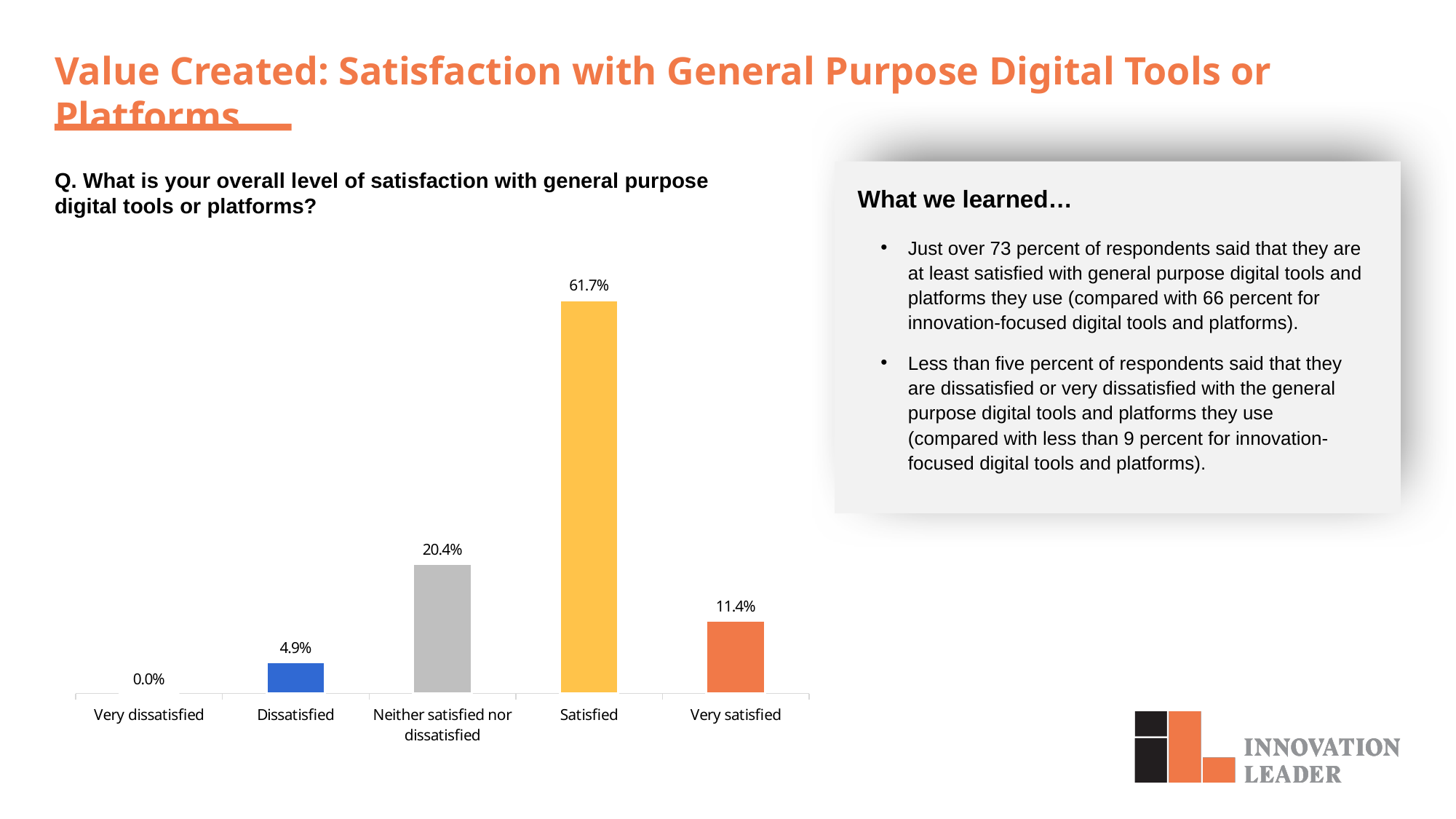
Which category has the highest value? Satisfied How many categories are shown on the x axis of the chart? 5 What is the difference between the Satisfied and Very satisfied values? 50.3% What is the value shown for Neither satisfied nor dissatisfied? 20.4% What colour is the bar for Satisfied? Yellow What kind of chart is shown on the slide? Bar chart What percentage of respondents said they are Satisfied with general purpose digital tools or platforms? 61.7% What is the value shown for Very dissatisfied? 0.0% Which is larger, the value for Neither satisfied nor dissatisfied or the value for Very satisfied? Neither satisfied nor dissatisfied What is the value shown for Very satisfied? 11.4% What is the value shown for Dissatisfied? 4.9% Which category has the lowest value? Very dissatisfied